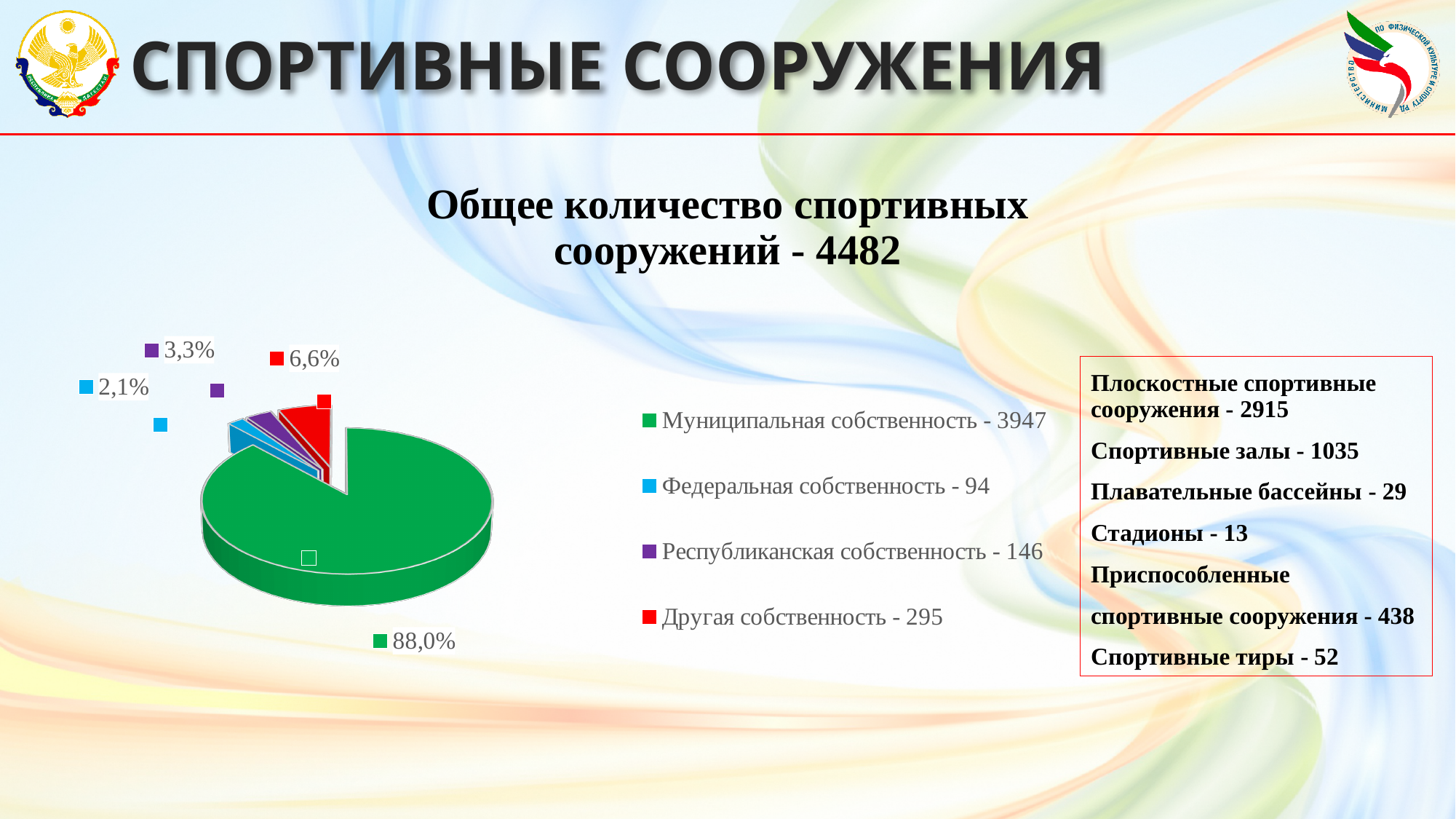
According to the legend, how many facilities are in Федеральная собственность? 94 What kind of chart is shown on the slide? pie chart What percentage share does the pie chart show for Республиканская собственность? 3,3% What percentage share does the pie chart show for Муниципальная собственность? 88,0% What percentage share does the pie chart show for Федеральная собственность? 2,1% How many entries does the legend of the pie chart list? 4 What is the difference between the number of facilities in Республиканская собственность and Федеральная собственность, according to the legend? 52 Which ownership category has the smallest slice in the pie chart? Федеральная собственность Which ownership category has the largest slice in the pie chart? Муниципальная собственность According to the legend, how many facilities are in Другая собственность? 295 How many slices does the pie chart have? 4